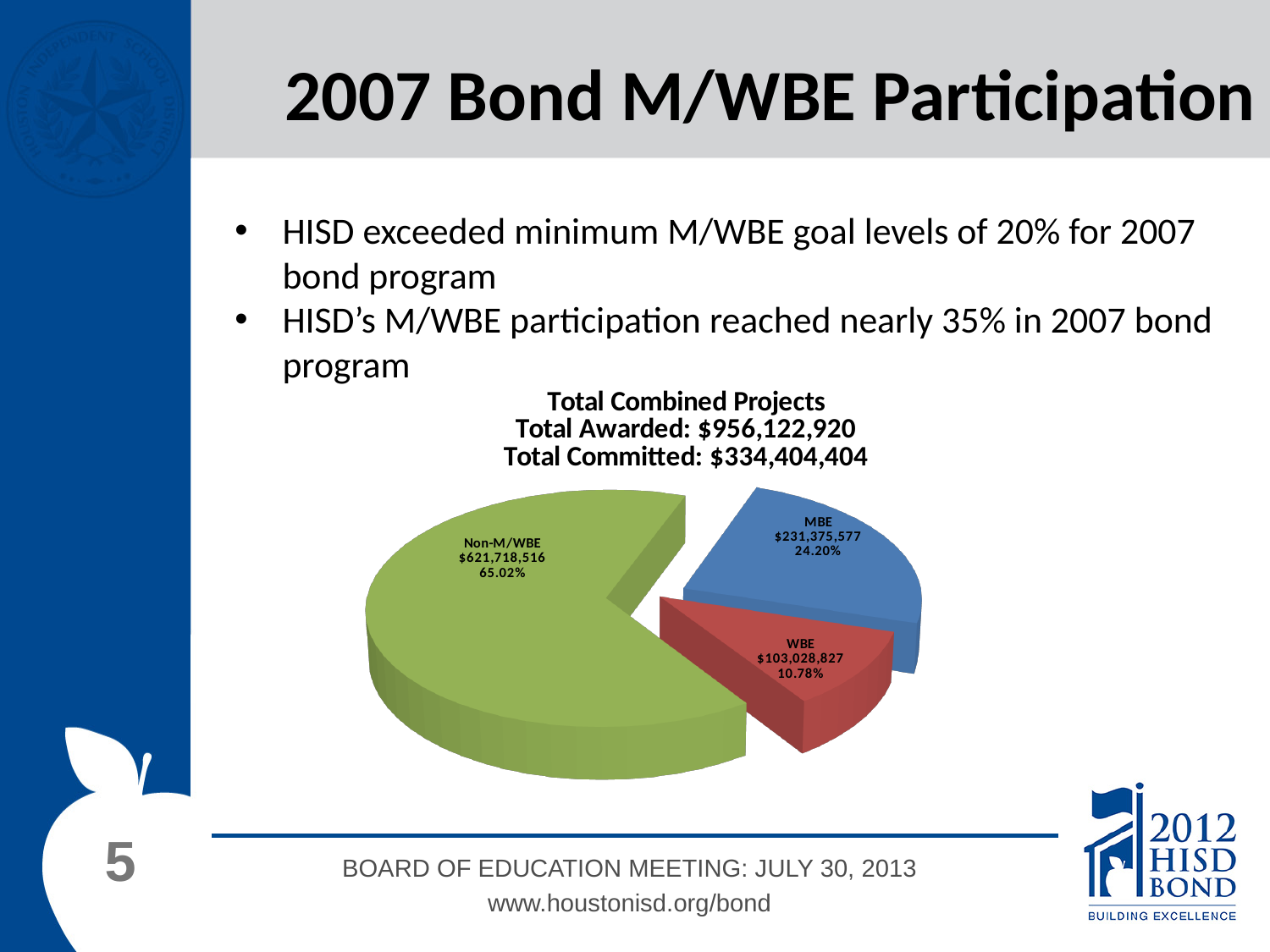
What share of the pie does the Non-M/WBE slice represent? 65.02% What type of chart is shown on the slide? pie chart What dollar amount is shown for the MBE slice? $231,375,577 How many slices does the pie chart have? 3 Which slice is larger, MBE or WBE? MBE What is the Total Awarded amount stated in the chart title? $956,122,920 Which slice of the pie chart is the largest? Non-M/WBE Which slice of the pie chart is the smallest? WBE What share of the pie does the WBE slice represent? 10.78% What dollar amount is shown for the Non-M/WBE slice? $621,718,516 What dollar amount is shown for the WBE slice? $103,028,827 What share of the pie does the MBE slice represent? 24.20%